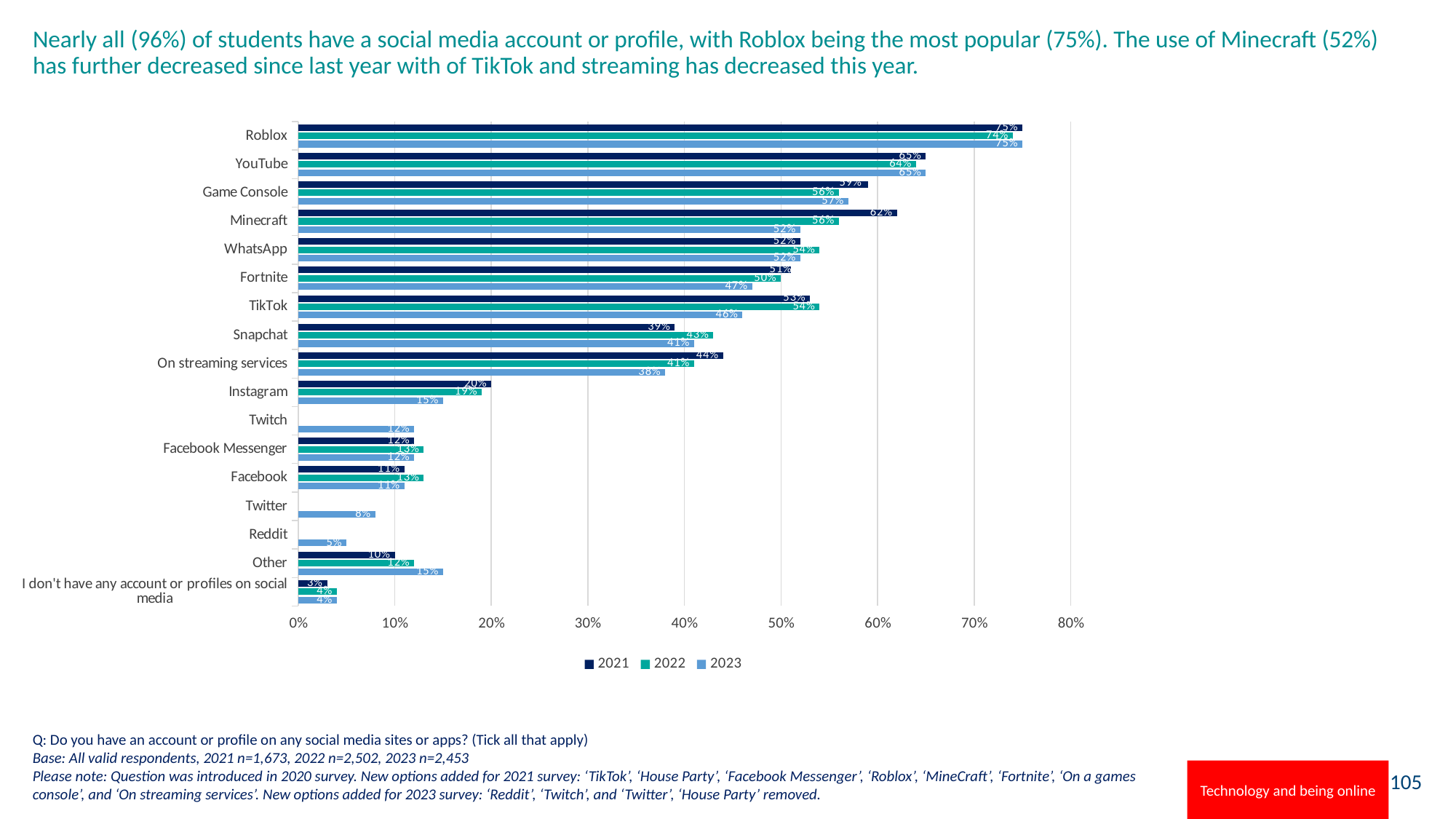
What is the 2023 value for Twitter? 8% What is the 2023 value for Reddit? 5% What is the 2023 value for TikTok? 46% What kind of chart is shown on the slide? bar chart What is the difference between the 2021 and 2023 values for Minecraft? 10 percentage points What are the entries listed in the legend? 2021, 2022, 2023 How many categories are shown on the y axis of the chart? 17 Do the values for Minecraft rise or fall from 2021 to 2023? fall What is the 2023 value for Minecraft? 52% Which has the larger 2023 value, Snapchat or On streaming services? Snapchat Which category has the highest 2023 value? Roblox How many series does the legend list? 3